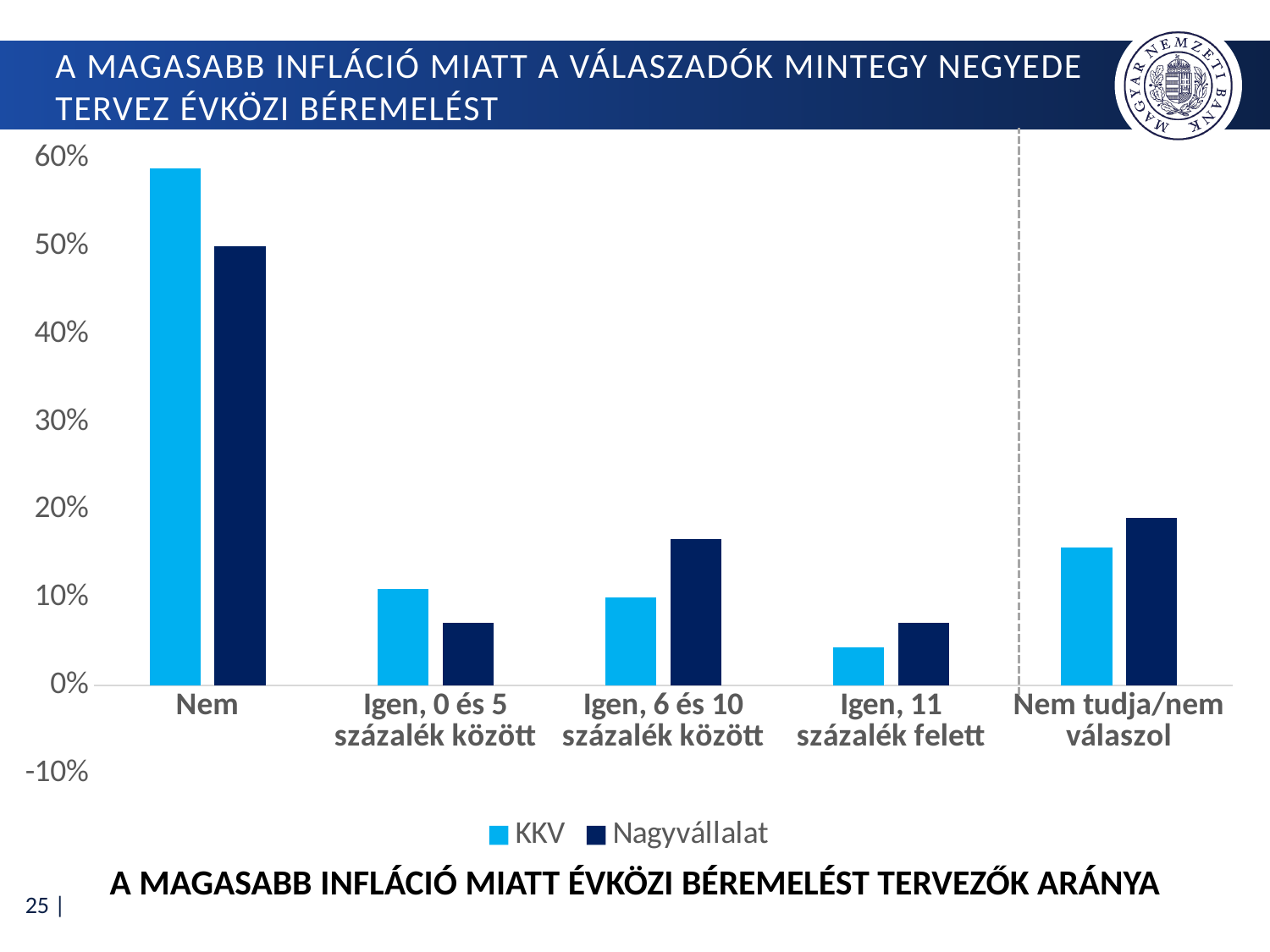
For the category Igen, 6 és 10 százalék között, which series has the larger value, KKV or Nagyvállalat? Nagyvállalat What kind of chart is shown on the slide? bar chart What are the two series named in the legend? KKV and Nagyvállalat Is the KKV value for Igen, 11 százalék felett greater or less than 10%? less For the category Nem, which series has the larger value, KKV or Nagyvállalat? KKV How many series does the legend list? 2 Is the Nagyvállalat value for Igen, 6 és 10 százalék között greater or less than 20%? less Is the KKV value for Nem greater or less than 50%? greater Which category has the highest Nagyvállalat value? Nem Which category has the highest KKV value? Nem How many categories are shown on the x axis? 5 Which category has the lowest KKV value? Igen, 11 százalék felett